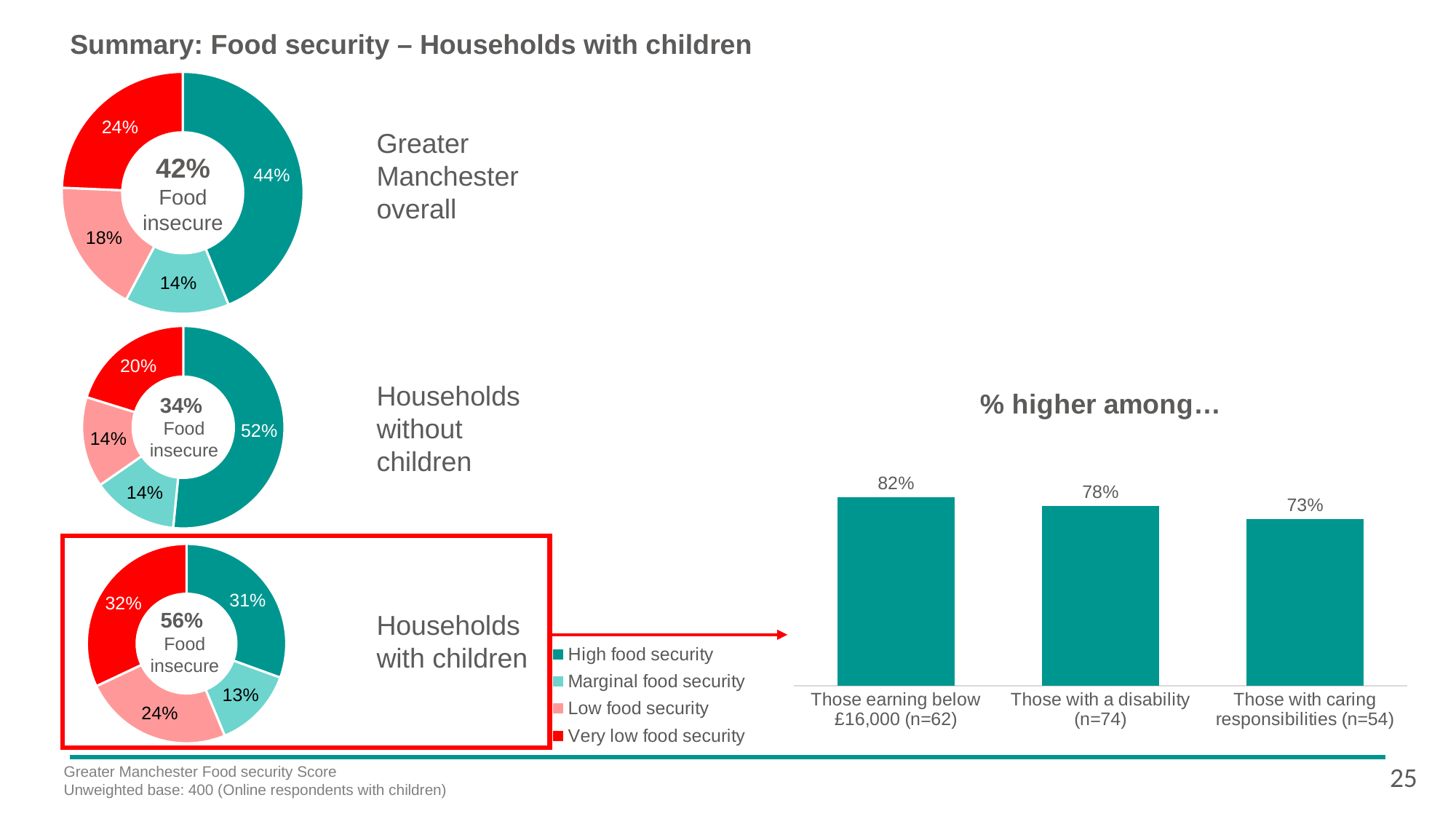
In the '% higher among…' bar chart, what is the difference between the values for 'Those earning below £16,000' and 'Those with caring responsibilities'? 9% How many bars are in the '% higher among…' bar chart? 3 What type of chart is the '% higher among…' chart? Bar chart In the '% higher among…' bar chart, which category has the highest value? Those earning below £16,000 (n=62) In the 'Households with children' donut chart, which is larger: the Very low food security slice or the High food security slice? Very low food security In the '% higher among…' bar chart, which category has the lowest value? Those with caring responsibilities (n=54) In the 'Households with children' donut chart, what is the food insecure percentage shown in the centre? 56% In the '% higher among…' bar chart, what is the value for 'Those with a disability (n=74)'? 78% In the 'Households with children' donut chart, what percentage is shown for Very low food security? 32% In the 'Greater Manchester overall' donut chart, what percentage is shown for High food security? 44% In the 'Households without children' donut chart, what percentage is shown for Low food security? 14% How many entries does the legend for the donut charts list? 4